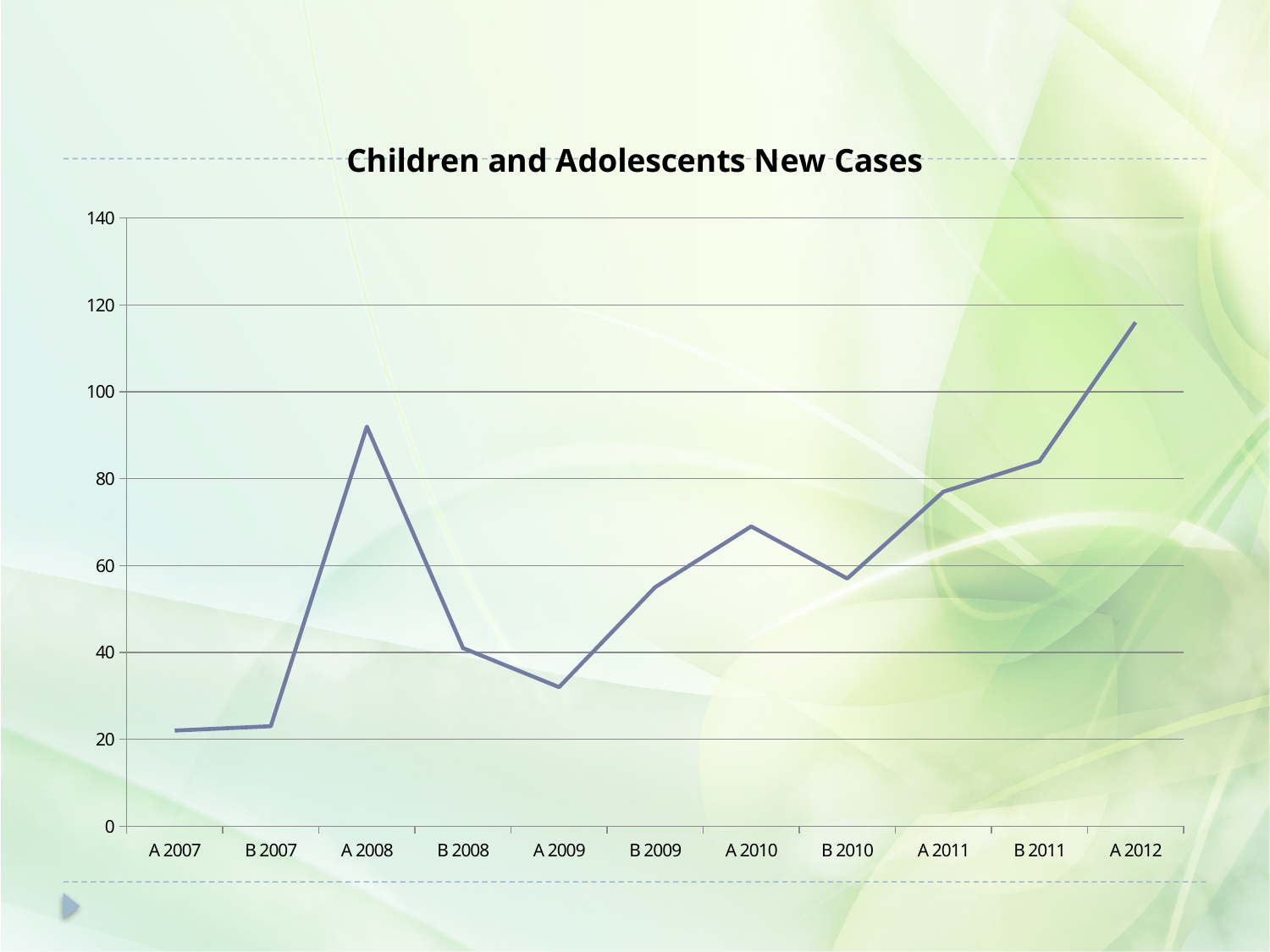
Is the value for A 2007 greater or less than 40? less Which is larger, the value for A 2008 or the value for B 2008? A 2008 Is the value for B 2011 greater or less than 80? greater How many data points are plotted along the x axis? 11 Is the value for A 2012 greater or less than 100? greater Do the values rise or fall from B 2010 to A 2012? rise Which period has the highest number of new cases? A 2012 What kind of chart is shown on the slide? line chart Which is larger, the value for A 2010 or the value for B 2010? A 2010 What is the title of the chart? Children and Adolescents New Cases